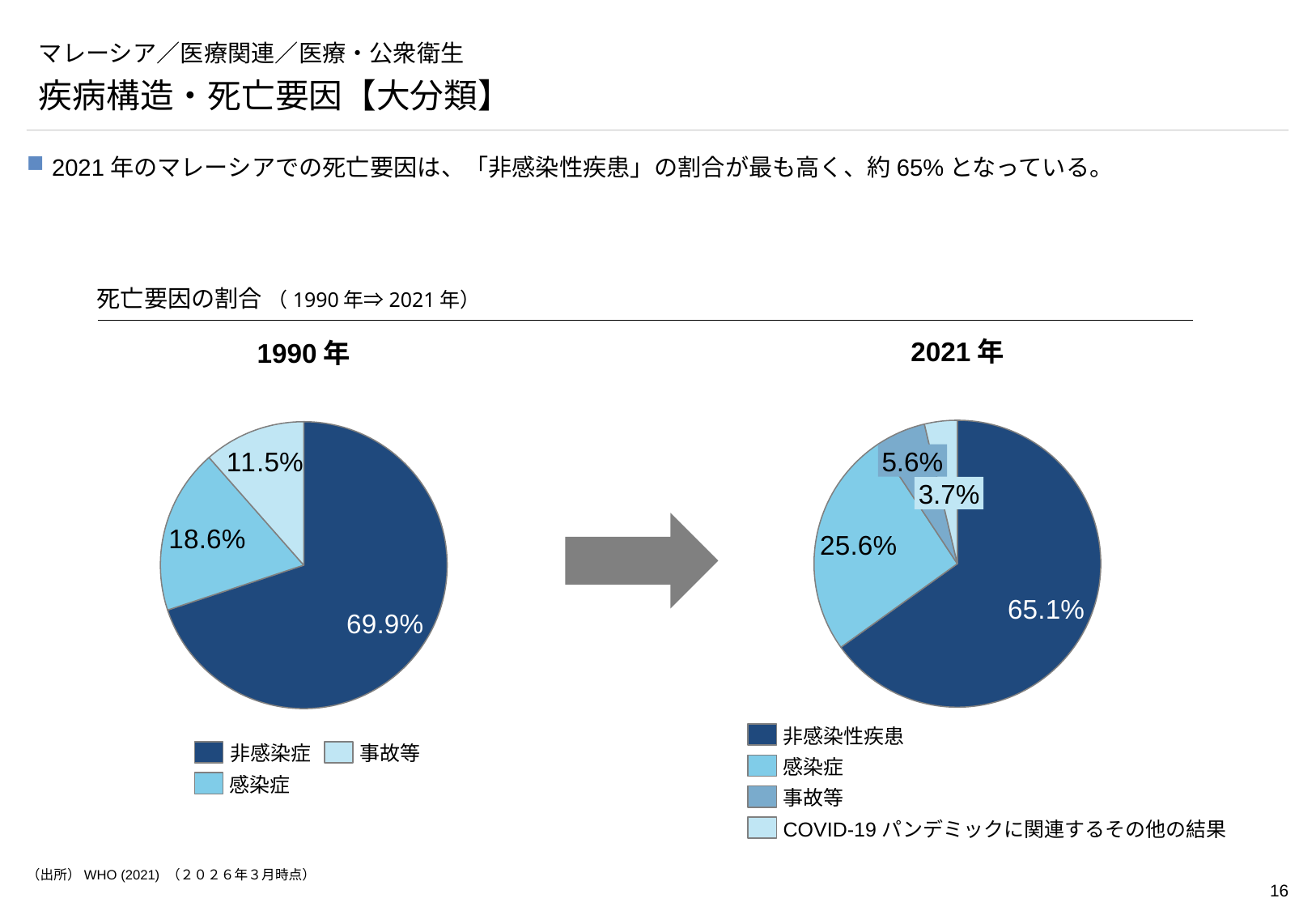
2021年の円グラフで、「感染症」の割合はいくらですか？ 25.6% 2021年の円グラフで、「非感染性疾患」の割合はいくらですか？ 65.1% 2021年の円グラフの凡例には、いくつの項目がありますか？ 4 1990年の円グラフで、最も割合が大きい項目はどれですか？ 非感染症 1990年の円グラフで、「非感染症」の割合はいくらですか？ 69.9% 1990年の円グラフと2021年の円グラフで、「感染症」の割合が大きいのはどちらの年ですか？ 2021年 このスライドのグラフはどの種類のグラフですか？ 円グラフ 2021年の円グラフで、「感染症」と「事故等」の割合の差はいくらですか？ 20.0% 2021年の円グラフで、最も割合が小さい項目はどれですか？ COVID-19 パンデミックに関連するその他の結果 1990年の円グラフで、「事故等」の割合はいくらですか？ 11.5% 1990年の円グラフで、「感染症」の割合はいくらですか？ 18.6% 2021年の円グラフで、「COVID-19 パンデミックに関連するその他の結果」の割合はいくらですか？ 3.7%